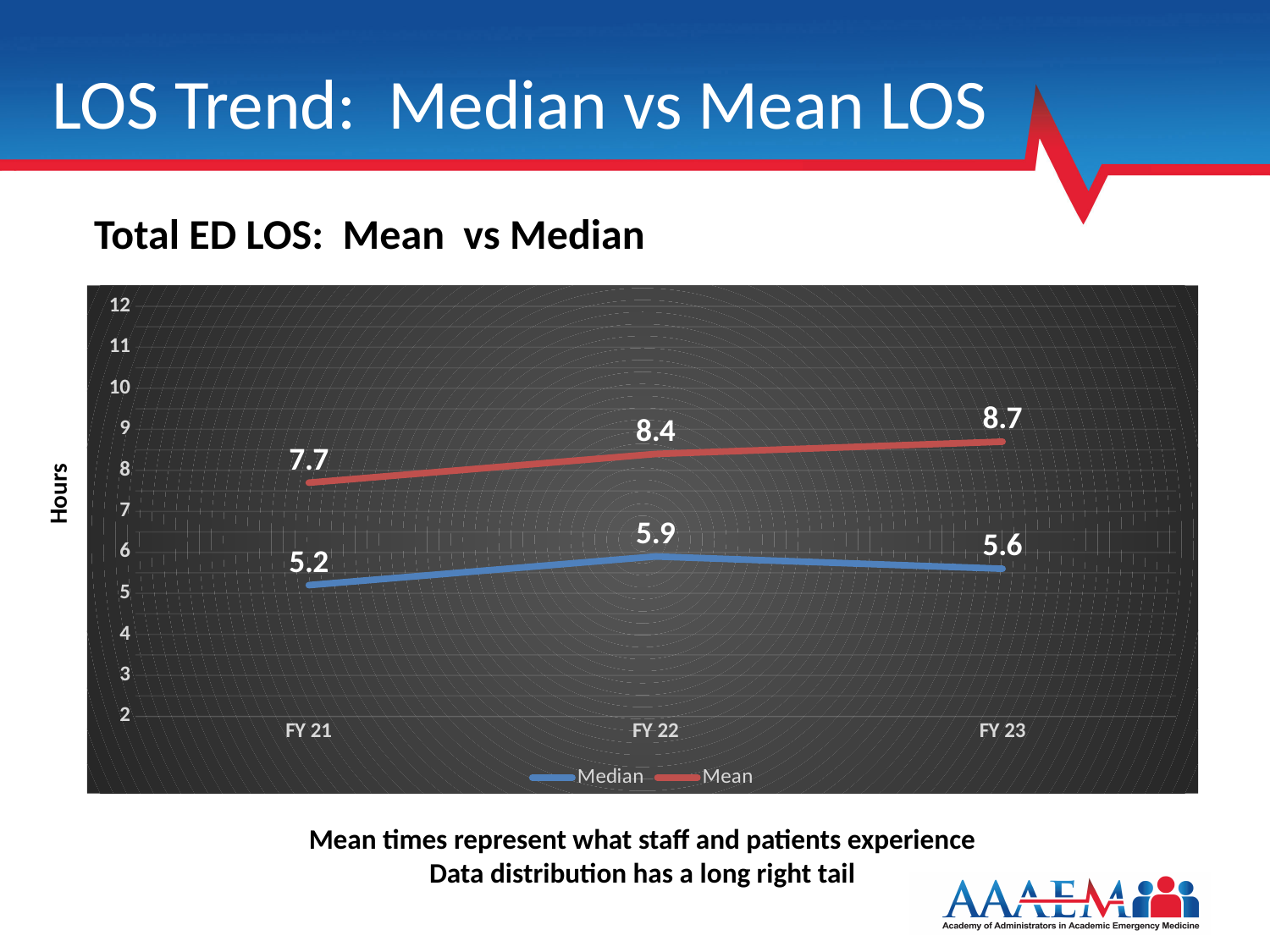
How many fiscal years are shown on the x axis? 3 What kind of chart is shown on the slide? Line chart In which fiscal year is the Mean LOS highest? FY 23 Does the Mean LOS rise or fall from FY 21 to FY 23? Rise In which fiscal year is the Median LOS lowest? FY 21 What is the Median LOS value for FY 23? 5.6 How many series does the legend list? 2 What is the Mean LOS value for FY 22? 8.4 What is the Median LOS value for FY 21? 5.2 By how much did the Mean LOS increase from FY 21 to FY 23? 1.0 What is the difference between the Mean and Median LOS in FY 23? 3.1 Which is larger in FY 22, the Mean LOS or the Median LOS? Mean